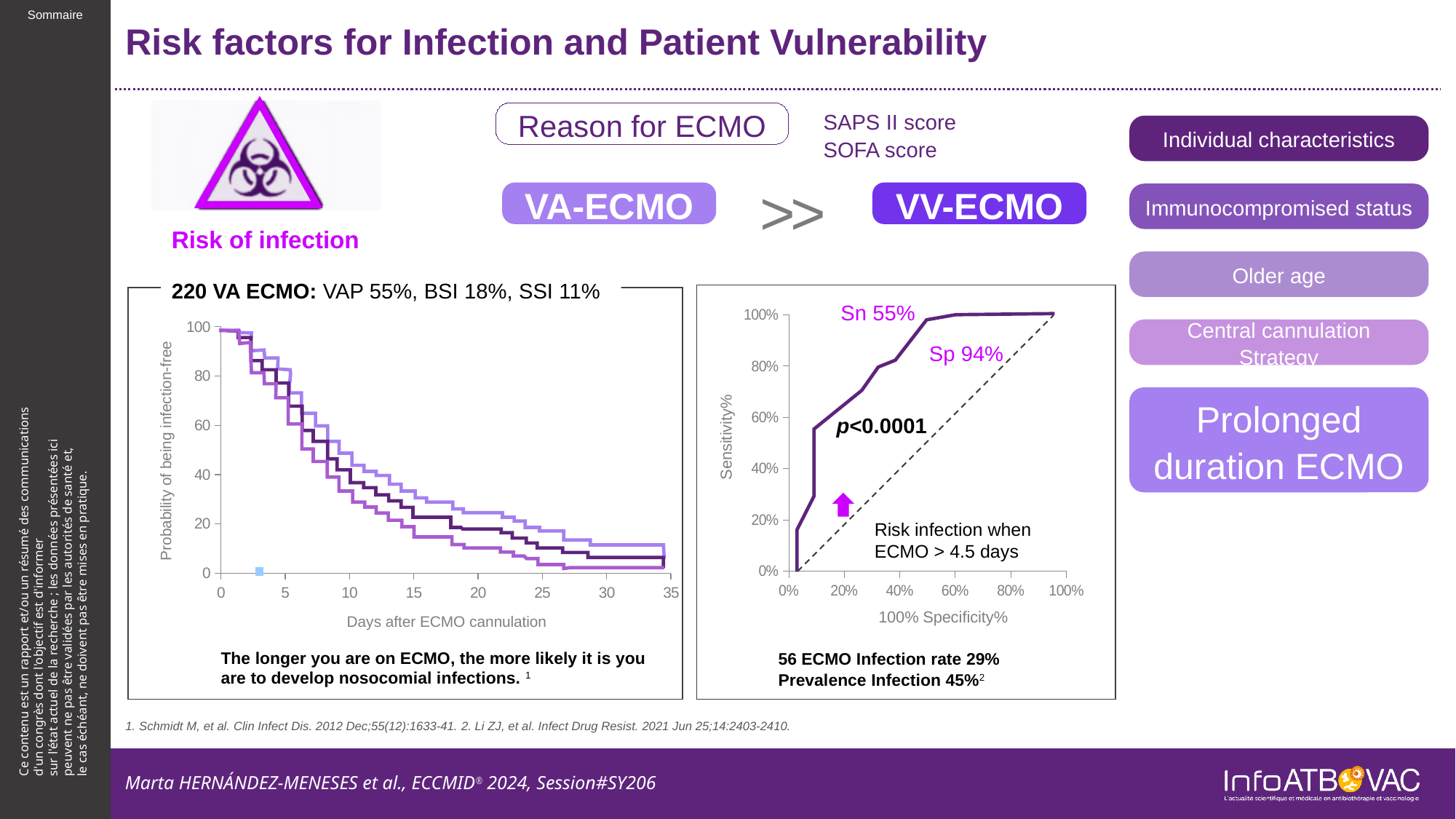
According to the right ROC chart, after how many days on ECMO does the risk of infection increase? 4.5 days In the left chart, what percentage of the 220 VA ECMO patients had BSI according to the chart title? 18% In the left chart, what is the label of the x axis? Days after ECMO cannulation In the left chart, does the probability of being infection-free rise or fall as days after ECMO cannulation increase? fall In the right ROC chart, what p-value is shown? p<0.0001 In the left chart, what is the highest value shown on the x axis? 35 What kind of chart is the left chart titled '220 VA ECMO'? line chart In the right ROC chart, what specificity (Sp) value is annotated? 94% In the left chart, what percentage of the 220 VA ECMO patients had VAP according to the chart title? 55% In the right ROC chart, what sensitivity (Sn) value is annotated? 55% In the right ROC chart, what is the label of the y axis? Sensitivity% How many curves are plotted in the left chart? 3